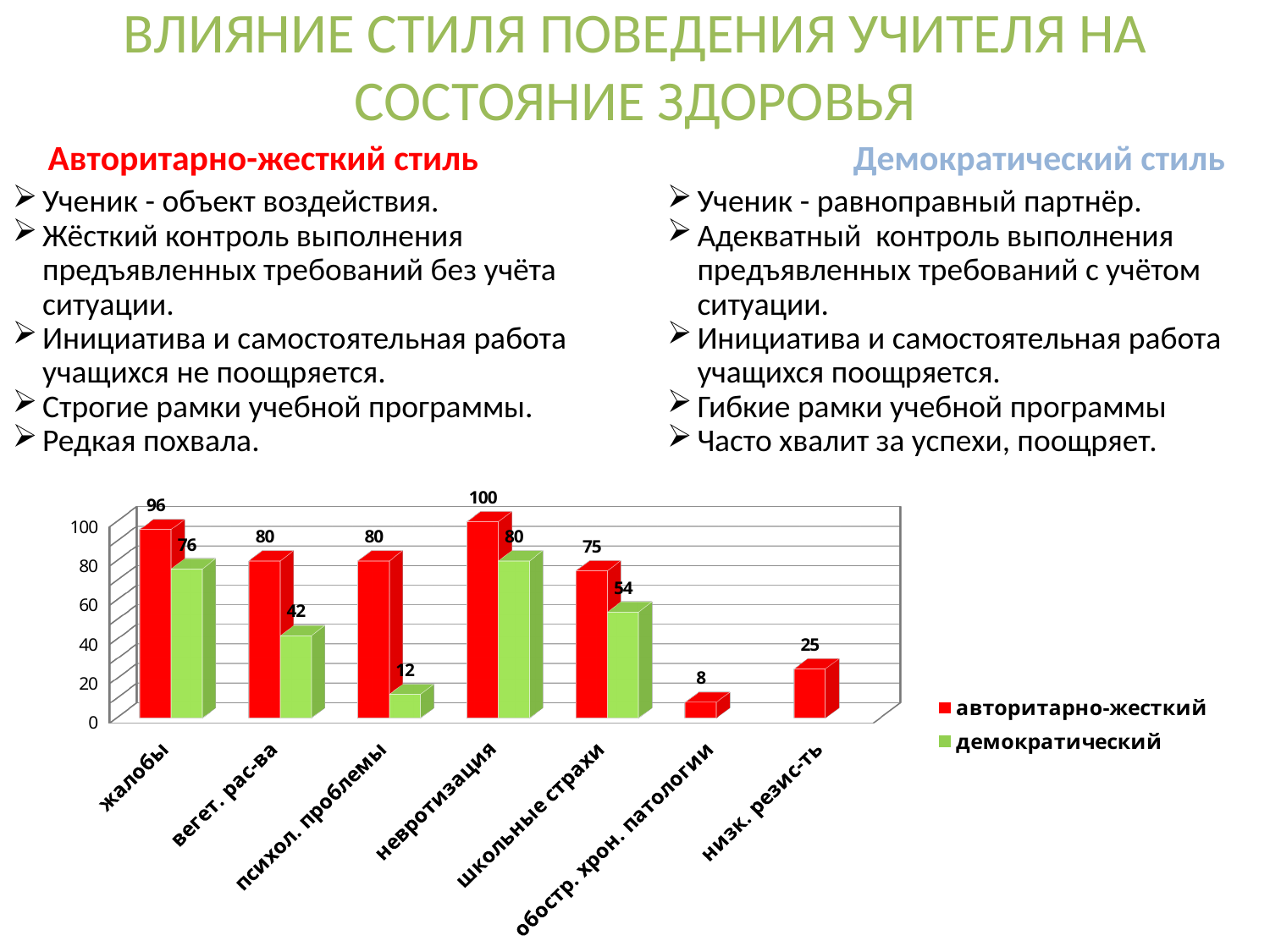
Which colour represents the 'демократический' series in the chart? green Which category has the lowest value in the 'авторитарно-жесткий' series? обостр. хрон. патологии Is the value for 'низк. резис-ть' in the 'авторитарно-жесткий' series greater or less than 40? less What is the difference between the 'авторитарно-жесткий' and 'демократический' values for 'вегет. рас-ва'? 38 What is the value for 'жалобы' in the 'авторитарно-жесткий' series? 96 What is the value for 'психол. проблемы' in the 'демократический' series? 12 What kind of chart is shown on the slide? bar chart Which category has the highest value in the 'авторитарно-жесткий' series? невротизация What is the value for 'школьные страхи' in the 'демократический' series? 54 How many series does the chart legend list? 2 For 'невротизация', which series has the larger value: 'авторитарно-жесткий' or 'демократический'? авторитарно-жесткий How many categories are shown on the x axis of the chart? 7